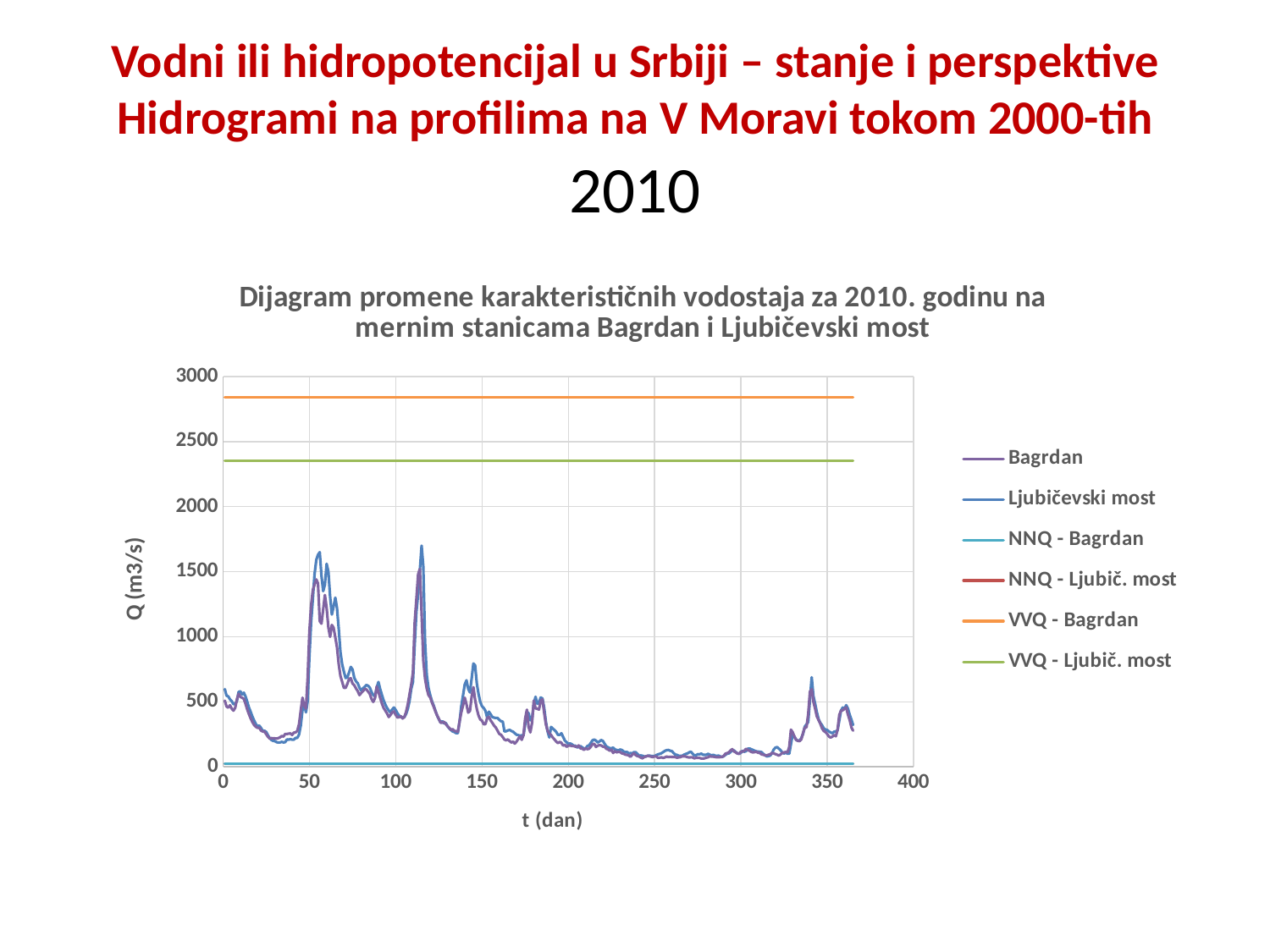
Which is larger, the VVQ - Bagrdan line or the VVQ - Ljubič. most line? VVQ - Bagrdan Is the value of the Bagrdan series around day 250 greater or less than 500? less How many series does the chart legend list? 6 Is the value of the VVQ - Ljubič. most line greater or less than 2500? less Is the value of the NNQ - Bagrdan line greater or less than 500? less Which series has the highest values on the chart? VVQ - Bagrdan What kind of chart is shown on the slide? line chart What is the label of the x axis of the chart? t (dan) What is the label of the y axis of the chart? Q (m3/s)